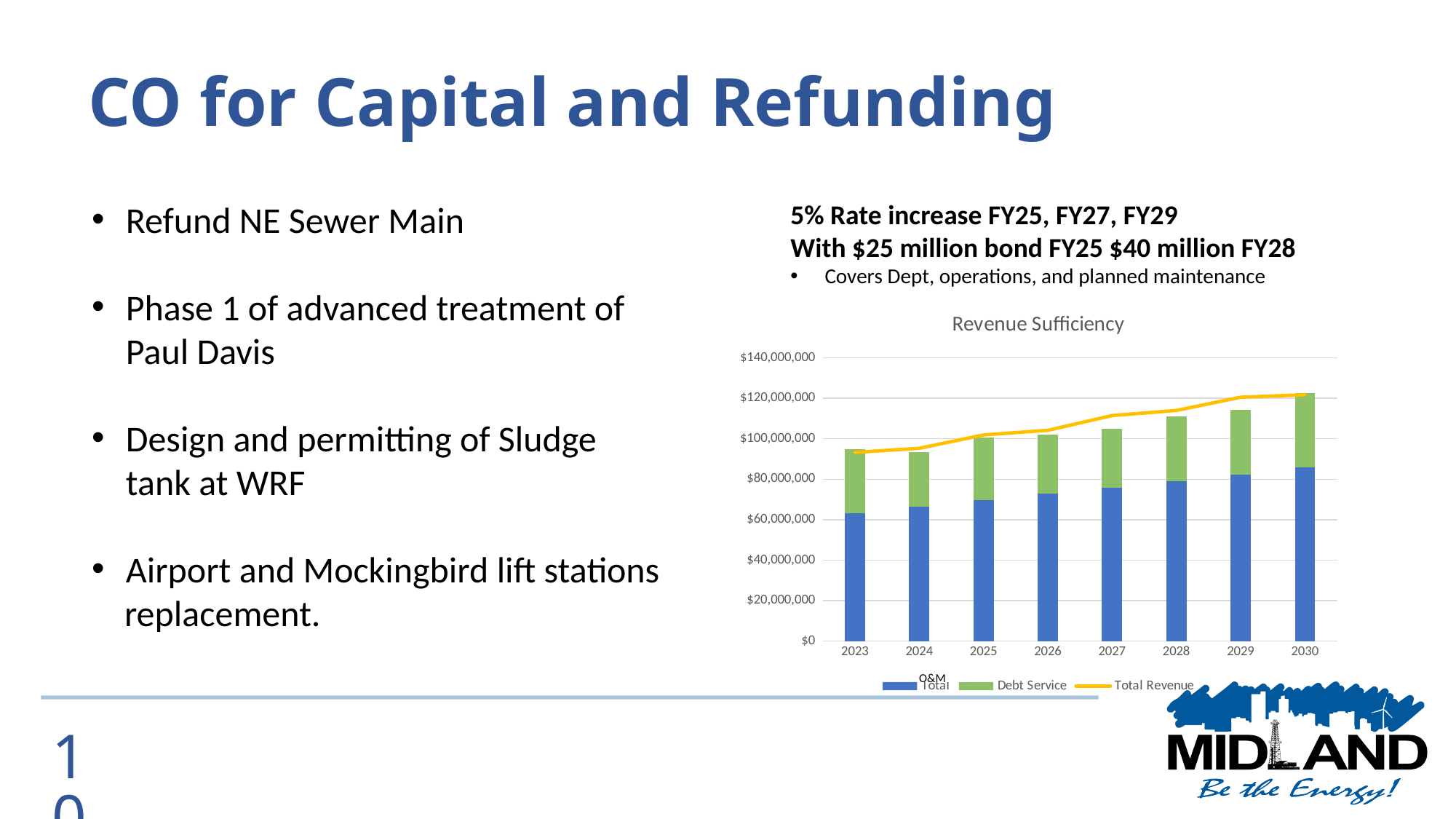
How many series does the legend of the Revenue Sufficiency chart list? 3 Is the O&M value for 2027 in the Revenue Sufficiency chart greater or less than $80,000,000? less Is the O&M value for 2023 in the Revenue Sufficiency chart greater or less than $60,000,000? greater What is the title of the chart on the slide? Revenue Sufficiency In the Revenue Sufficiency chart, does the O&M value rise or fall from 2023 to 2030? Rise In the Revenue Sufficiency chart, is the O&M value larger in 2030 or in 2023? 2030 In the Revenue Sufficiency chart, which year has the highest O&M value? 2030 In the Revenue Sufficiency chart, which year has the lowest O&M value? 2023 Is the Total Revenue value for 2023 in the Revenue Sufficiency chart greater or less than $100,000,000? less Which series in the Revenue Sufficiency chart is drawn as a line rather than bars? Total Revenue What type of chart is the Revenue Sufficiency chart? Stacked bar chart with a line How many years are shown on the x axis of the Revenue Sufficiency chart? 8